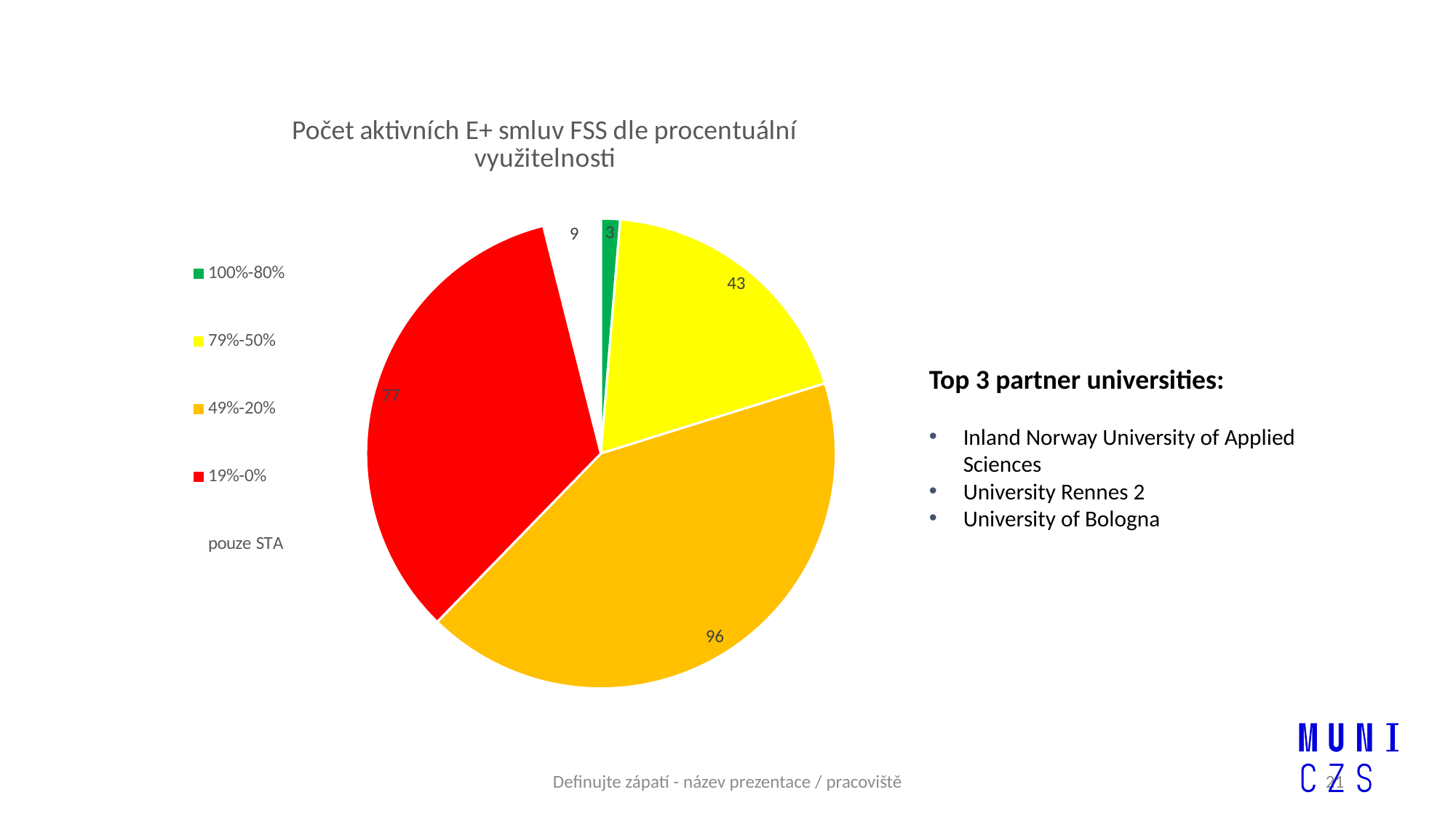
Which category has the smallest slice? 100%-80% What is the value for the 49%-20% slice? 96 What type of chart is shown on the slide? pie chart Which category has the largest slice? 49%-20% What is the value for the 79%-50% slice? 43 Which is larger, the 79%-50% slice or the 19%-0% slice? 19%-0% What is the value for the 19%-0% slice? 77 What is the value for the 100%-80% slice? 3 What is the value for the pouze STA slice? 9 What is the title of the chart? Počet aktivních E+ smluv FSS dle procentuální využitelnosti What is the difference between the 49%-20% and 19%-0% values? 19 How many slices does the pie chart have? 5